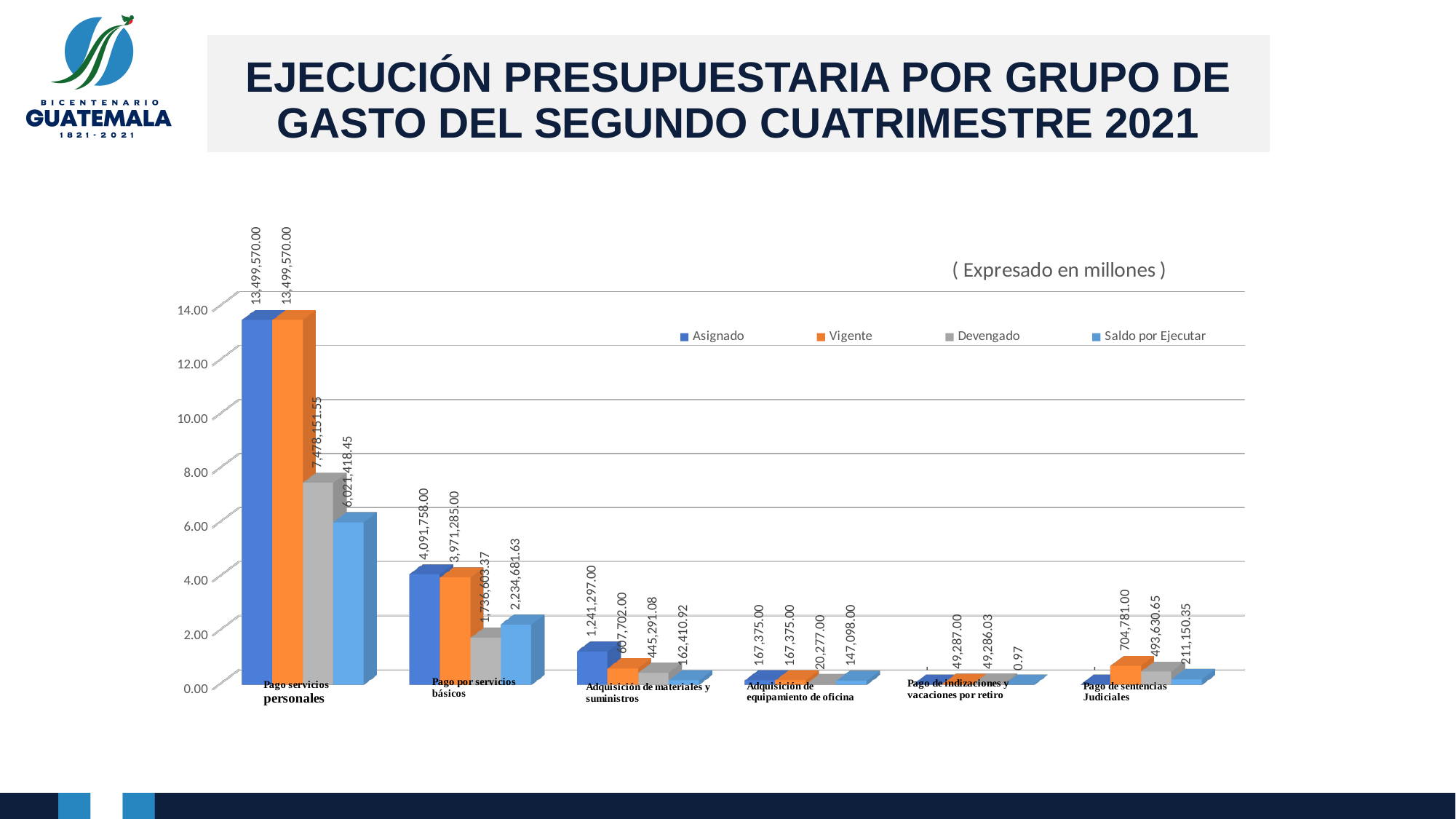
What is the Saldo por Ejecutar value for Pago por servicios básicos? 2,234,681.63 For Pago servicios personales, which is larger: Devengado or Saldo por Ejecutar? Devengado What is the Devengado value for Pago servicios personales? 7,478,151.55 How many series does the chart legend list? 4 How many expense group categories are plotted on the x axis? 6 What is the Vigente value for Pago de sentencias Judiciales? 704,781.00 What are the four series named in the legend? Asignado, Vigente, Devengado, Saldo por Ejecutar What is the difference between the Asignado and Vigente values for Pago por servicios básicos? 120,473.00 Which category has the highest Asignado value? Pago servicios personales What is the Devengado value for Adquisición de equipamiento de oficina? 20,277.00 What kind of chart is shown on the slide? Bar chart What is the Saldo por Ejecutar value for Pago de indizaciones y vacaciones por retiro? 0.97